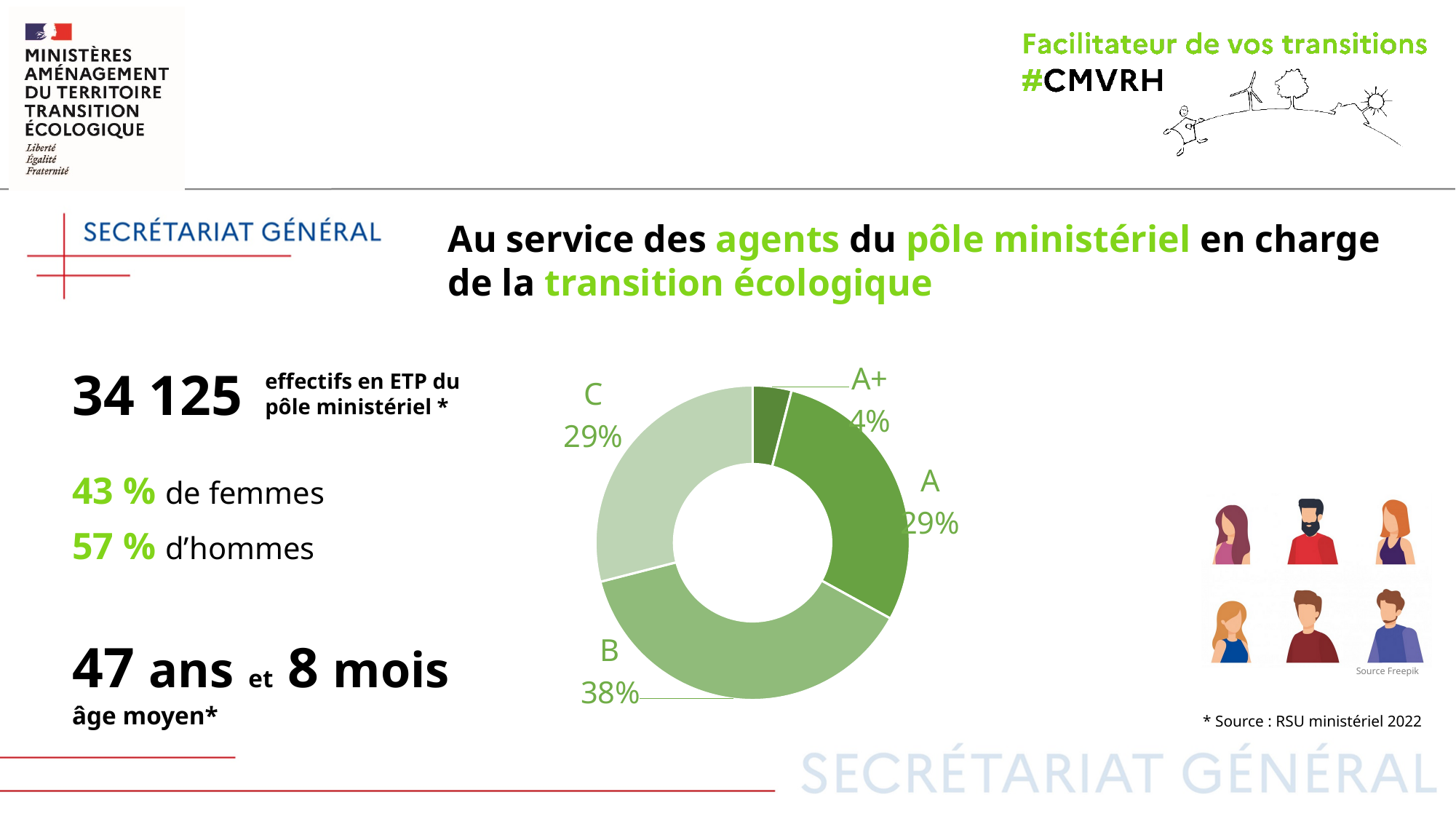
What is the difference in percentage points between category B and category A in the donut chart? 9 What share of the donut chart does category B represent? 38% What kind of chart is shown on the slide? Donut (pie) chart What percentage is shown for category C in the donut chart? 29% Which category has the smallest slice in the donut chart? A+ How many categories are shown in the donut chart? 4 What percentage is shown for category A in the donut chart? 29% Which is larger in the donut chart, the slice for A or the slice for A+? A Which category has the largest slice in the donut chart? B What percentage is shown for category A+ in the donut chart? 4% Which is larger in the donut chart, the slice for B or the slice for C? B What is the combined share of categories A and A+ in the donut chart? 33%